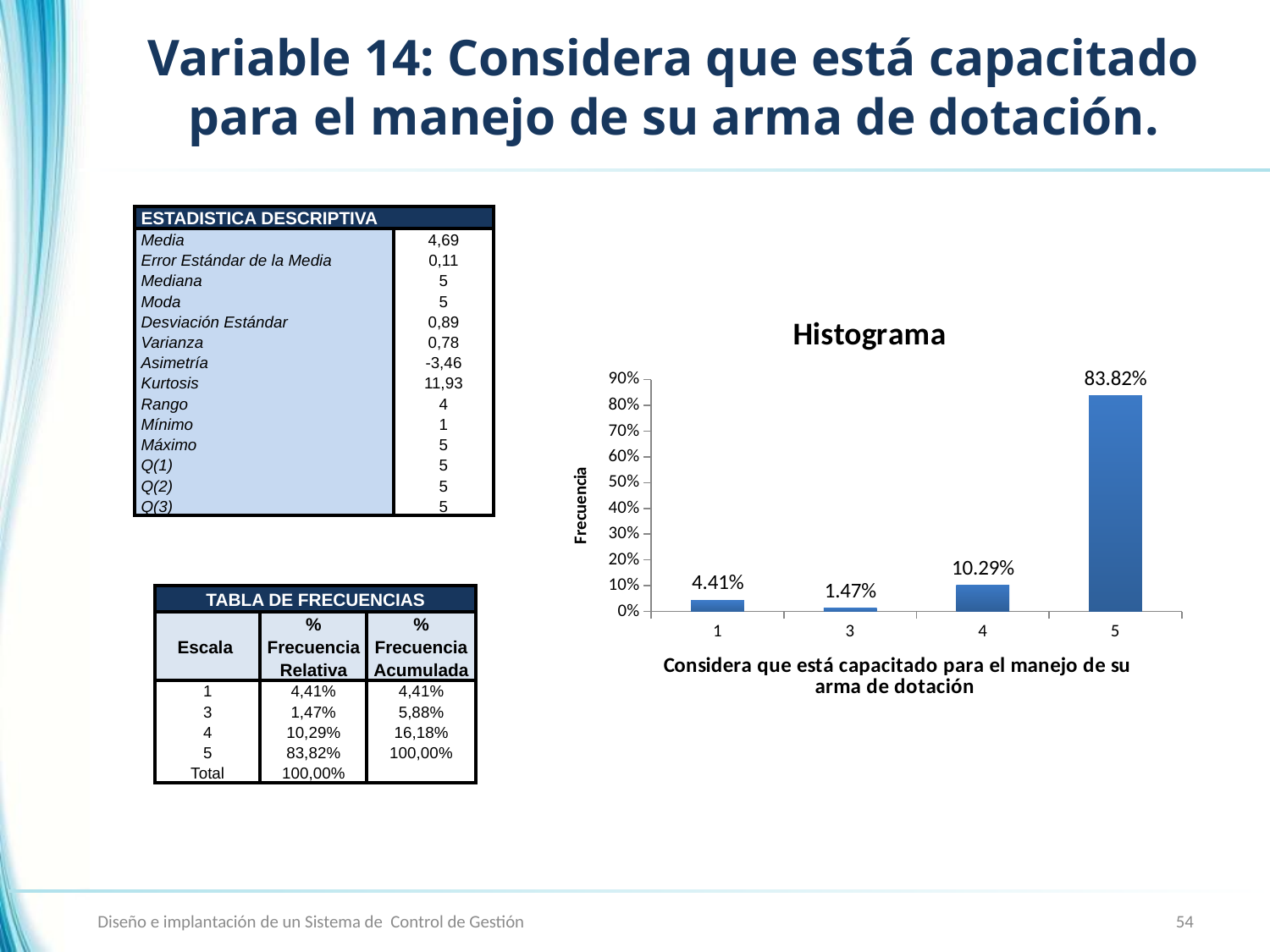
What is the y-axis label of the Histograma chart? Frecuencia Which is larger in the Histograma chart, the value for category 1 or category 4? 4 What is the value for category 4 in the Histograma chart? 10.29% Is the value for category 5 in the Histograma chart greater or less than 80%? greater What kind of chart is the Histograma chart? bar chart What is the value for category 1 in the Histograma chart? 4.41% How many categories are shown on the x axis of the Histograma chart? 4 Which category has the lowest value in the Histograma chart? 3 What is the value for category 3 in the Histograma chart? 1.47% What is the value for category 5 in the Histograma chart? 83.82% Which category has the highest value in the Histograma chart? 5 What is the difference between the values for category 5 and category 4 in the Histograma chart? 73.53%